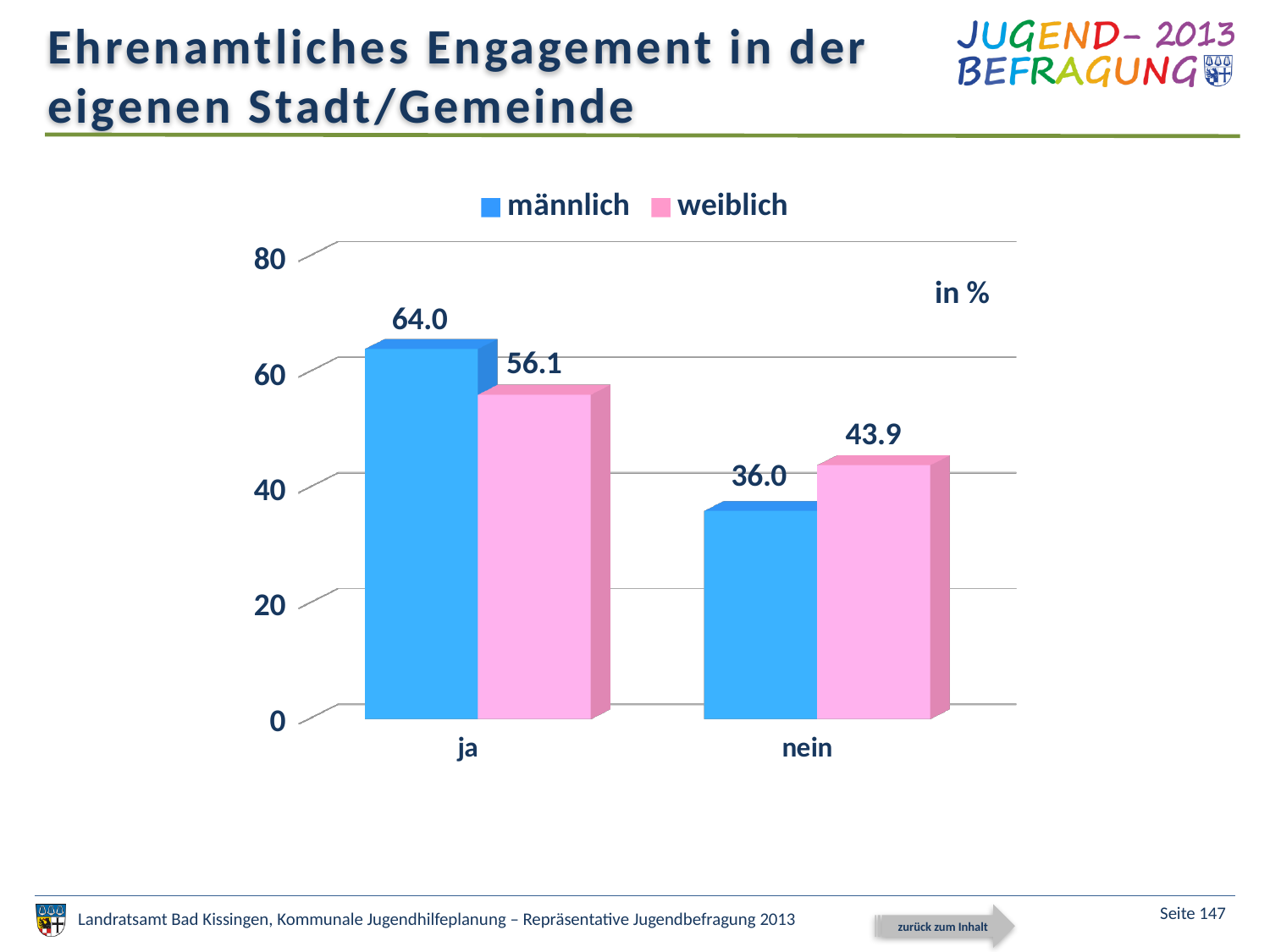
What is the value for männlich in the nein category? 36.0 What unit is indicated for the values on the chart? in % What is the value for weiblich in the nein category? 43.9 Which bar has the lowest value on the chart? männlich, nein What is the value for weiblich in the ja category? 56.1 What is the value for männlich in the ja category? 64.0 In the nein category, which series has the larger value, männlich or weiblich? weiblich Which bar has the highest value on the chart? männlich, ja How many categories are shown on the x axis? 2 How many series does the legend list? 2 What kind of chart is shown on the slide? bar chart What is the difference between the männlich and weiblich values in the ja category? 7.9